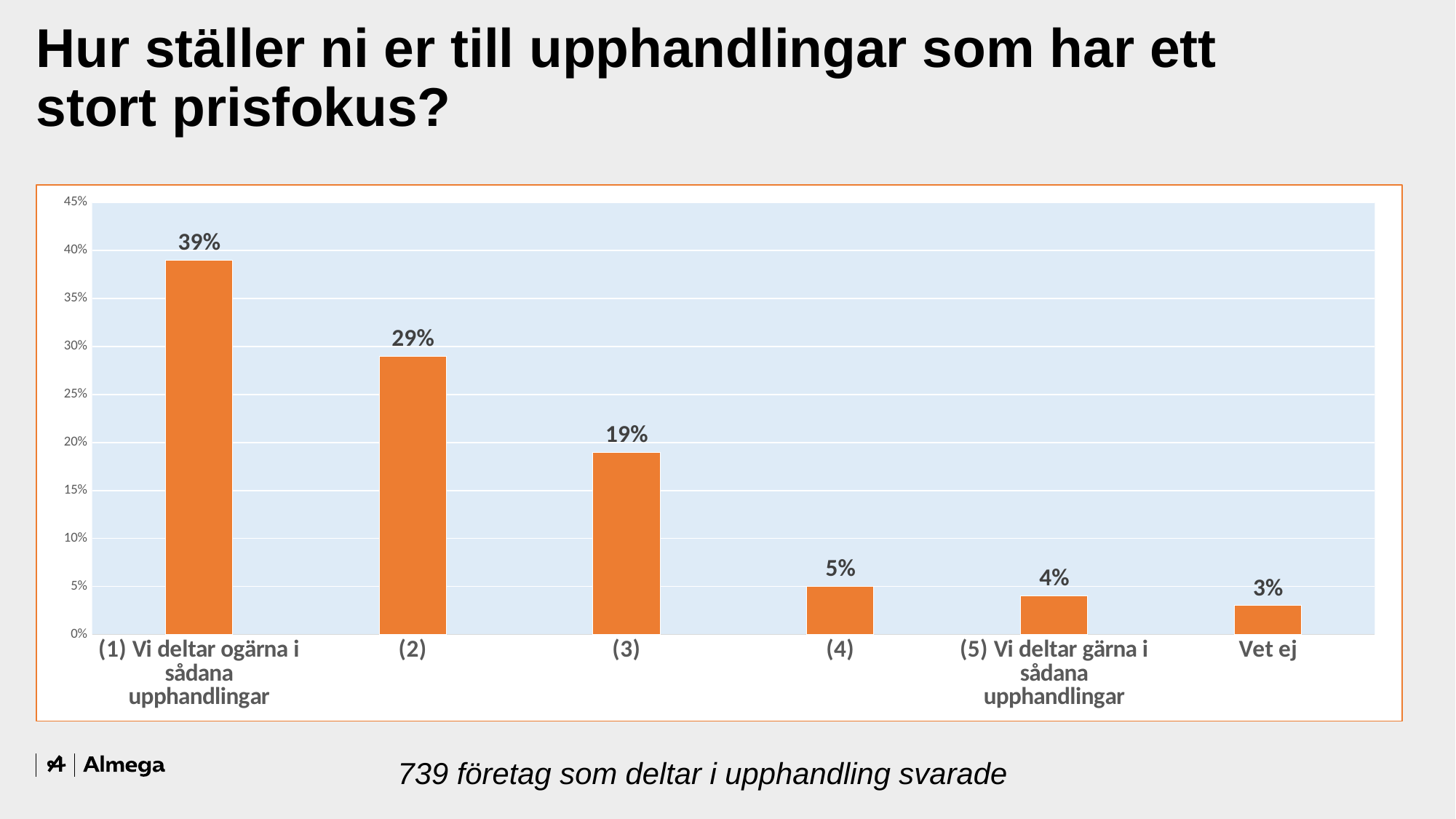
What kind of chart is shown on the slide? bar chart What is the value for "Vet ej"? 3% How many categories are shown on the x axis? 6 Which category has the lowest value? Vet ej Which is larger, the value for "(2)" or the value for "(3)"? (2) Do the values rise or fall from left to right along the x axis? fall What is the difference between the values for "(1) Vi deltar ogärna i sådana upphandlingar" and "(2)"? 10% Which category has the highest value? (1) Vi deltar ogärna i sådana upphandlingar What is the value for "(5) Vi deltar gärna i sådana upphandlingar"? 4% Is the value for "(2)" greater or less than 25%? greater What is the value for "(1) Vi deltar ogärna i sådana upphandlingar"? 39% What is the value for category "(3)"? 19%